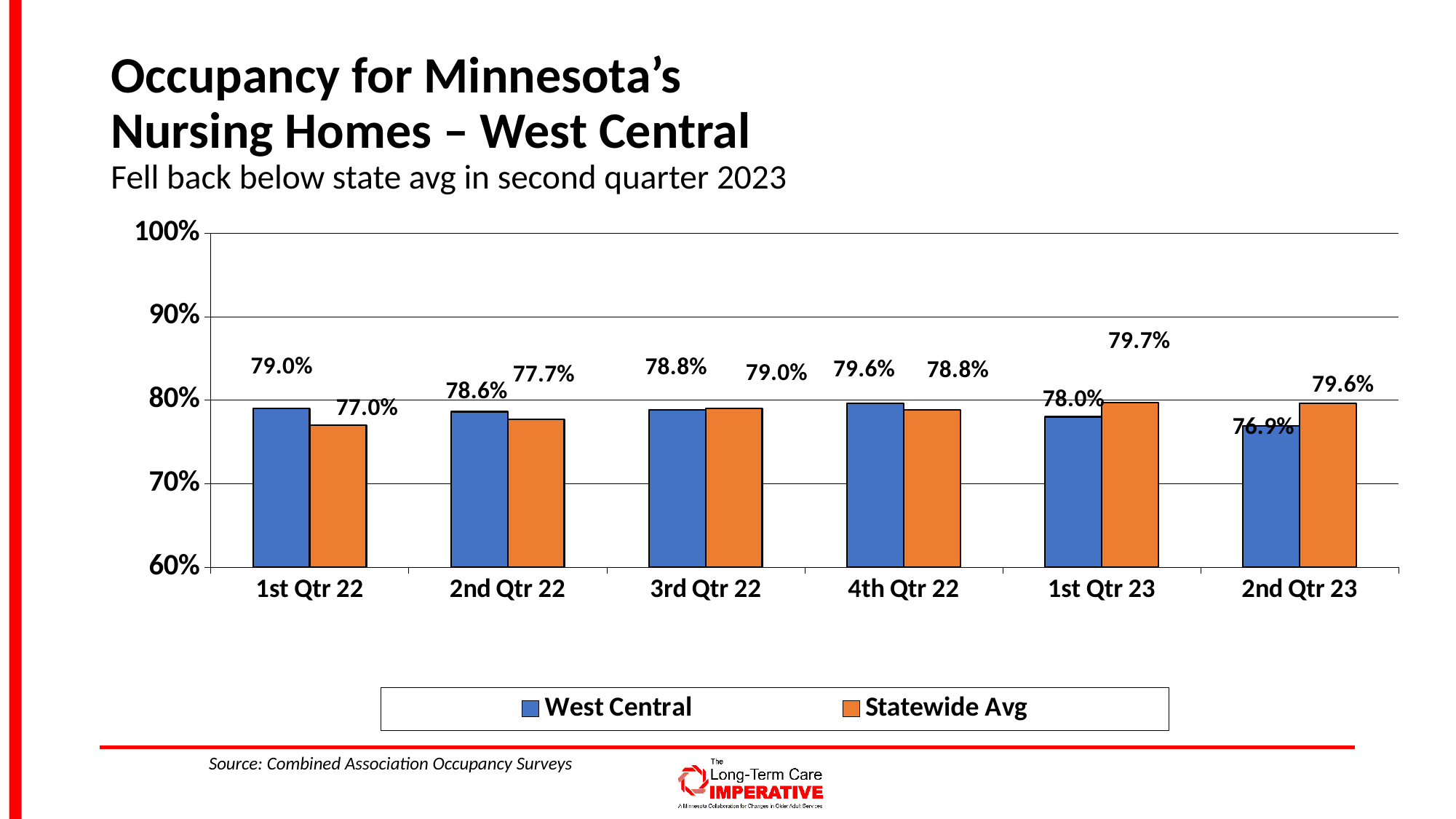
What is the West Central occupancy value for 1st Qtr 22? 79.0% Which is larger in 1st Qtr 22, West Central or Statewide Avg? West Central In which quarter is the Statewide Avg occupancy highest? 1st Qtr 23 What is the Statewide Avg occupancy value for 1st Qtr 22? 77.0% What kind of chart is shown on the slide? Bar chart How many series does the legend list? 2 In which quarter is the West Central occupancy lowest? 2nd Qtr 23 How many quarters are shown on the x axis? 6 What is the difference between the Statewide Avg and West Central values in 2nd Qtr 23? 2.7% Is the West Central value for 2nd Qtr 23 greater or less than 80%? less What is the Statewide Avg occupancy value for 2nd Qtr 23? 79.6% What is the West Central occupancy value for 4th Qtr 22? 79.6%